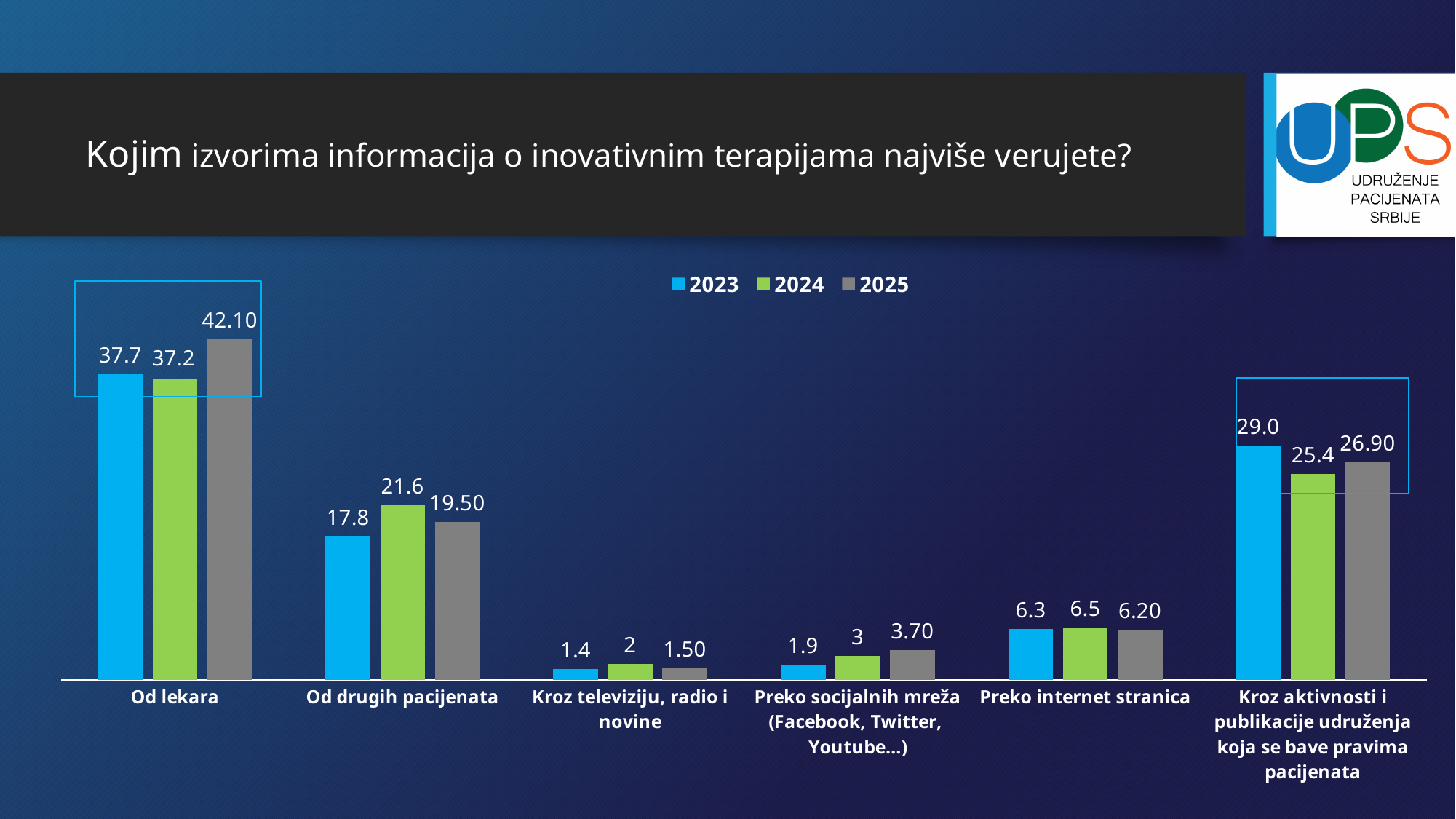
What is the difference between the 2023 and 2024 values for "Kroz aktivnosti i publikacije udruženja koja se bave pravima pacijenata"? 3.6 What is the value for "Od drugih pacijenata" in the 2024 series? 21.6 What is the value for "Od lekara" in the 2025 series? 42.10 Which category has the lowest value in the 2025 series? Kroz televiziju, radio i novine What is the difference between the 2025 and 2023 values for "Od lekara"? 4.4 For "Od drugih pacijenata", which series has the larger value: 2023 or 2025? 2025 Which category has the highest value in the 2023 series? Od lekara What is the 2023 value for "Preko internet stranica"? 6.3 What kind of chart is shown on the slide? Bar chart What is the 2024 value for "Preko socijalnih mreža (Facebook, Twitter, Youtube...)"? 3 How many series does the legend list? 3 How many categories are shown on the x axis? 6